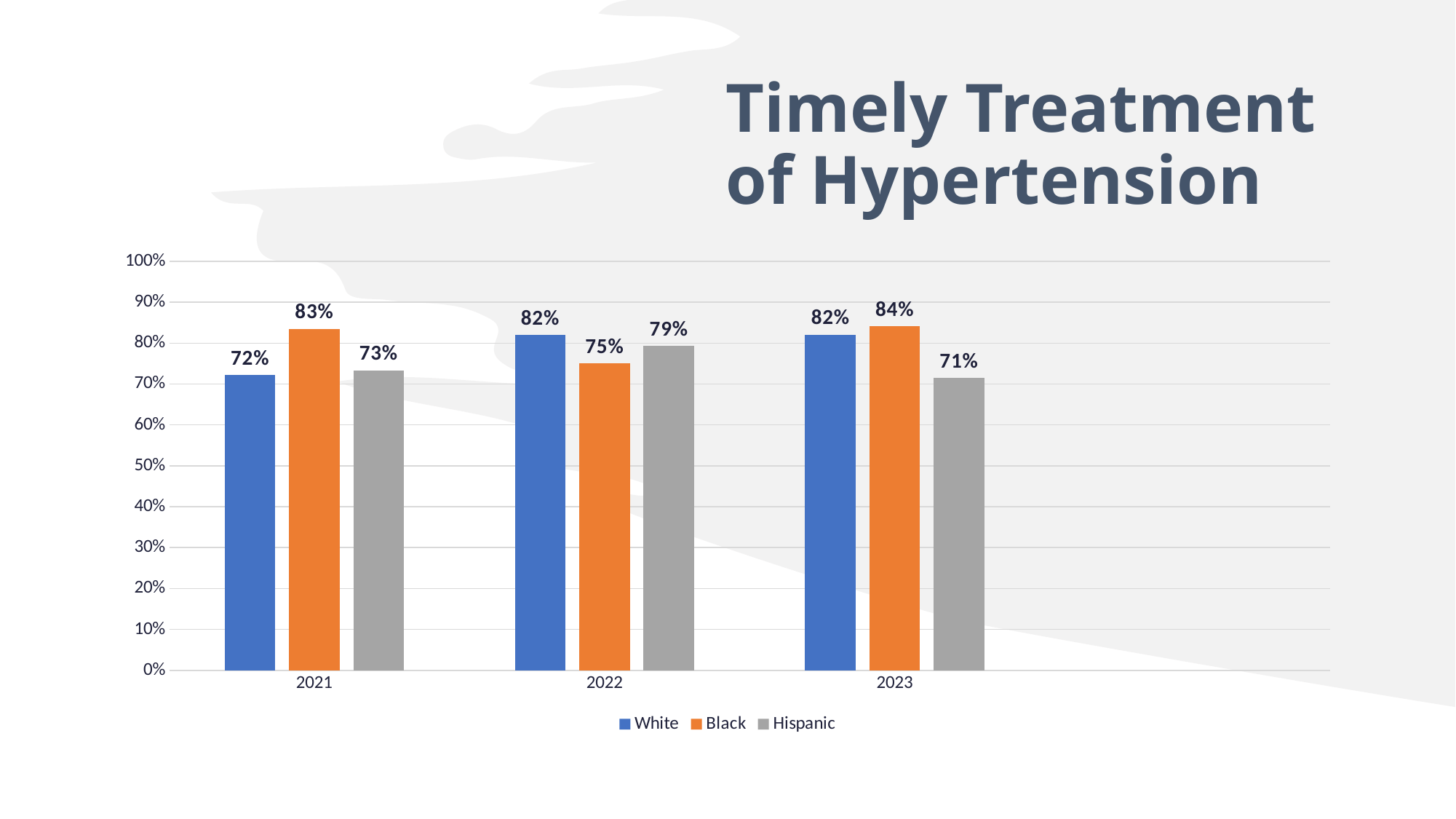
How many years are shown on the x axis? 3 How many series does the legend list? 3 Which group has the highest value in 2022? White What kind of chart is shown on the slide? Bar chart What is the value for Hispanic in 2022? 79% What is the difference between the Black and White values in 2021? 11% Which is larger in 2022: the value for Black or the value for Hispanic? Hispanic Is the value for Hispanic in 2023 greater or less than 80%? less What is the value for Black in 2023? 84% What is the value for White in 2021? 72% Does the value for Hispanic rise or fall from 2022 to 2023? Fall Which group has the lowest value in 2023? Hispanic